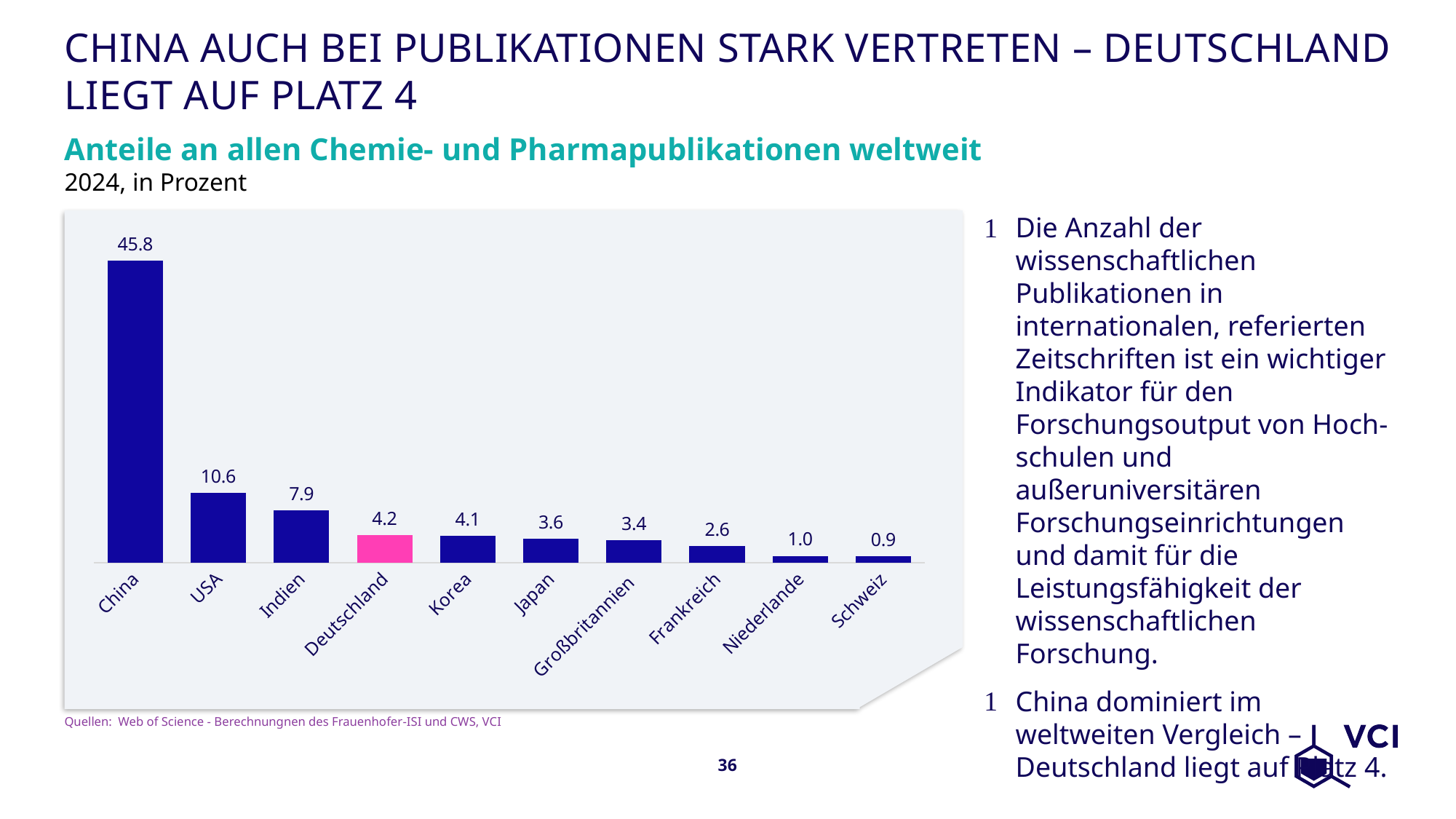
What is the value for China? 45.8 How many countries are shown in the chart? 10 What is the value for Großbritannien? 3.4 What is the value for Deutschland? 4.2 What is the difference between the values for China and USA? 35.2 Which country has the highest share? China Which bar is highlighted in a different colour (pink) from the others? Deutschland What kind of chart is shown on the slide? bar chart Do the values rise or fall from left to right along the x axis? fall Which is larger, the value for Japan or the value for Frankreich? Japan Which country has the lowest share? Schweiz What is the difference between the values for USA and Indien? 2.7